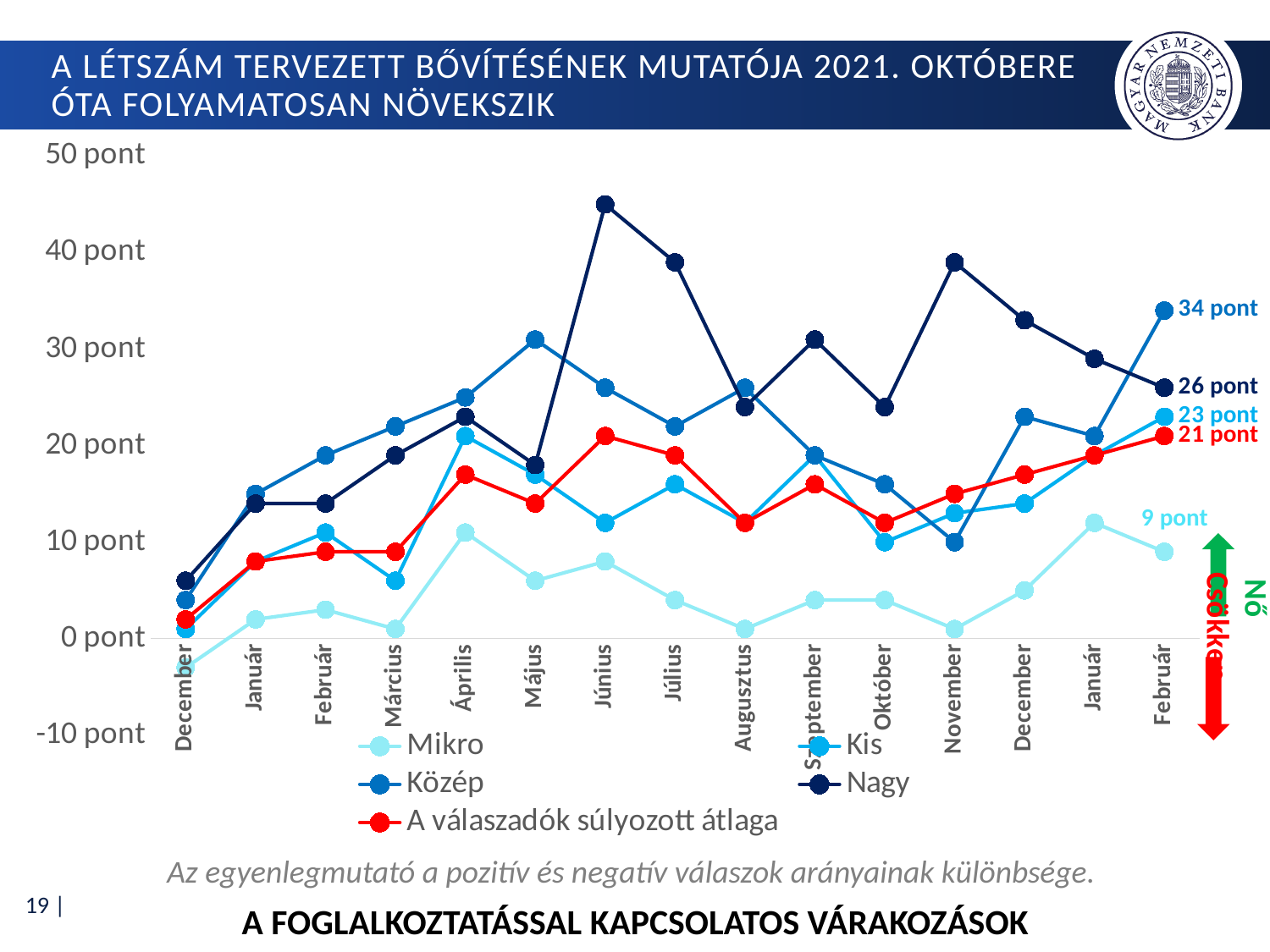
What is the value for Közép at the final Február point? 34 pont Does the Nagy series rise or fall from November to the final Február? fall What is the value for A válaszadók súlyozott átlaga at the final Február point? 21 pont Is the value for Nagy in Június greater or less than 40 pont? greater What kind of chart is shown on the slide? line chart At the final Február point, what is the difference between the Közép value and the Nagy value? 8 pont What is the value for Nagy at the final Február point? 26 pont Which series has the highest value at the final Február point? Közép At the final Február point, which is larger: the Nagy value or the Kis value? Nagy How many series does the legend list? 5 What is the value for Kis at the final Február point? 23 pont Which series has the lowest value at the final Február point? Mikro